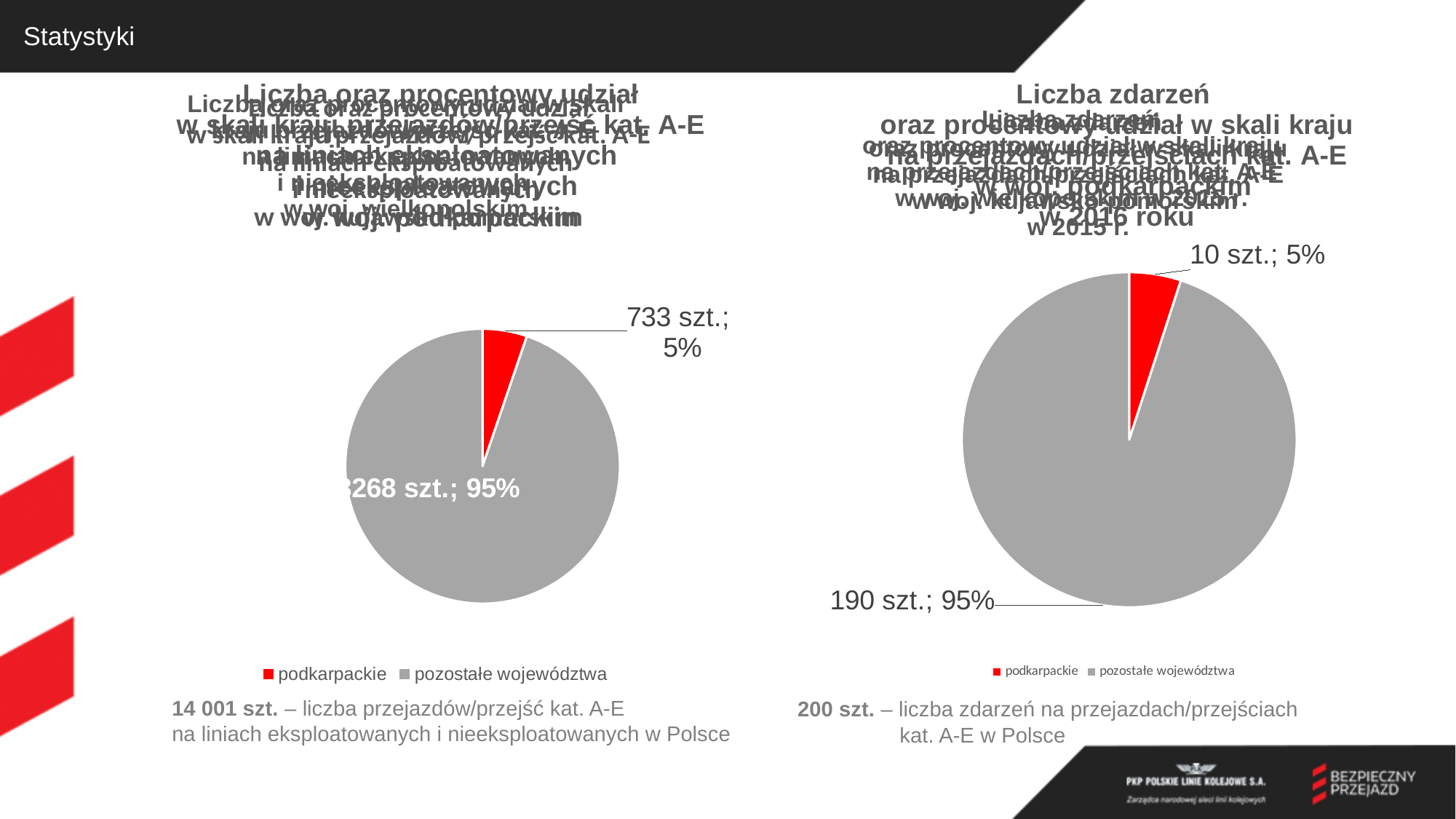
In the left pie chart, which colour represents podkarpackie? Red In the right pie chart, what is the data label for the pozostałe województwa slice? 190 szt.; 95% How many slices does the left pie chart have? 2 In the right pie chart, what is the total of the two slices in szt.? 200 szt. How many entries does the legend of the right pie chart list? 2 In the left pie chart, what is the data label for the podkarpackie slice? 733 szt.; 5% In the right pie chart, what is the data label for the podkarpackie slice? 10 szt.; 5% What type of chart is shown on the left side of the slide? Pie chart In the right pie chart, which slice is larger: podkarpackie or pozostałe województwa? pozostałe województwa In the left pie chart, what percentage share does pozostałe województwa have? 95% In the right pie chart, what is the difference in szt. between pozostałe województwa and podkarpackie? 180 szt. In the left pie chart, what percentage share does podkarpackie have? 5%